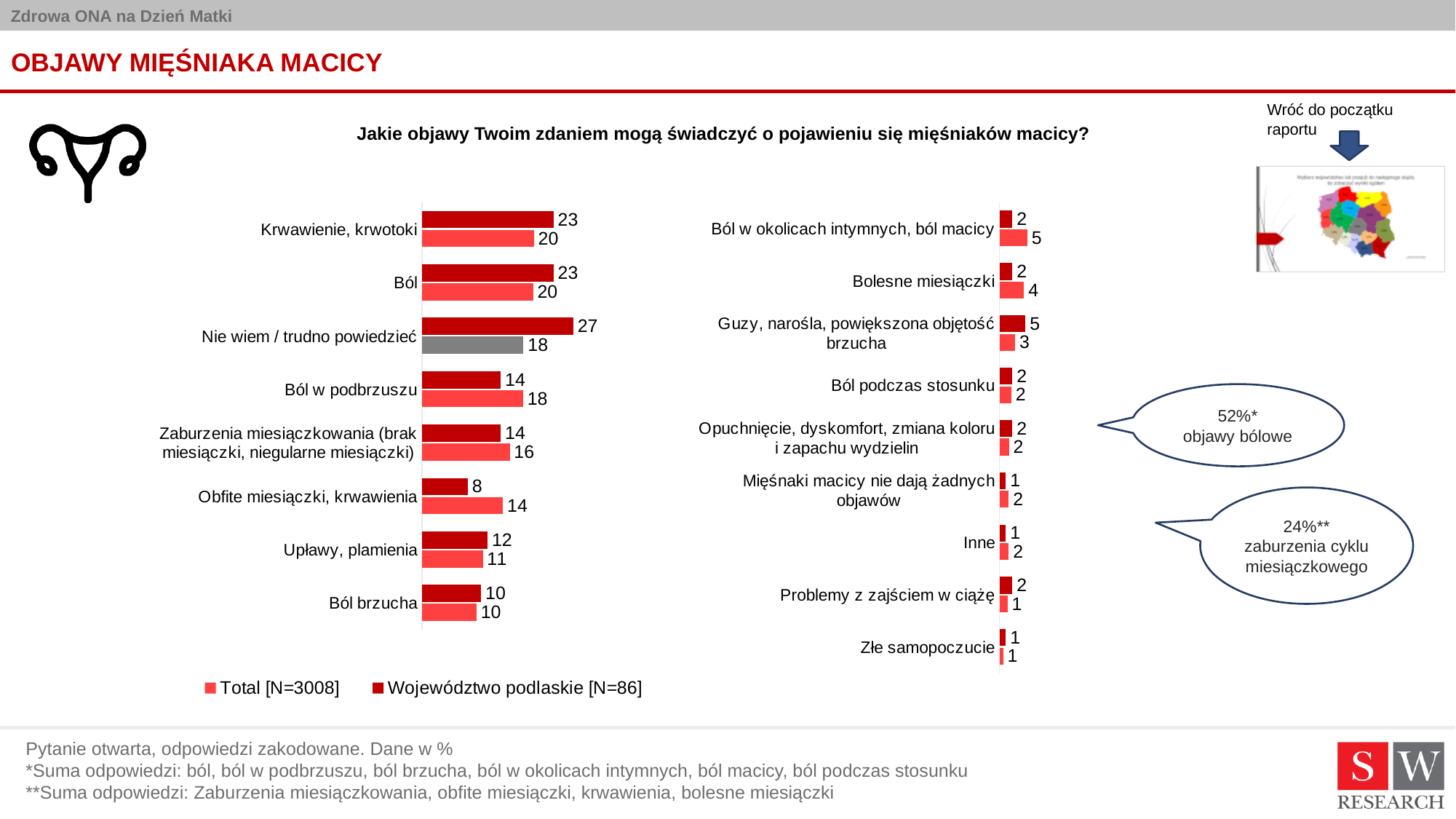
In the right chart, what is the value for Województwo podlaskie [N=86] for 'Guzy, narośla, powiększona objętość brzucha'? 5 In the left chart, what is the difference between the Total and Województwo podlaskie values for 'Obfite miesiączki, krwawienia'? 6 In the left chart, which category has the highest value for Województwo podlaskie [N=86]? Nie wiem / trudno powiedzieć In the left chart, what is the value for Województwo podlaskie [N=86] for 'Nie wiem / trudno powiedzieć'? 27 How many categories does the left chart show? 8 In the left chart, which is larger for 'Ból w podbrzuszu': the Total value or the Województwo podlaskie value? Total [N=3008] How many series does the legend list? 2 In the left chart, which category has the lowest value for Województwo podlaskie [N=86]? Obfite miesiączki, krwawienia In the right chart, what is the value for Total [N=3008] for 'Ból w okolicach intymnych, ból macicy'? 5 In the left chart, what is the value for Total [N=3008] for 'Krwawienie, krwotoki'? 20 What type of chart is the left chart? Bar chart How many categories does the right chart show? 9